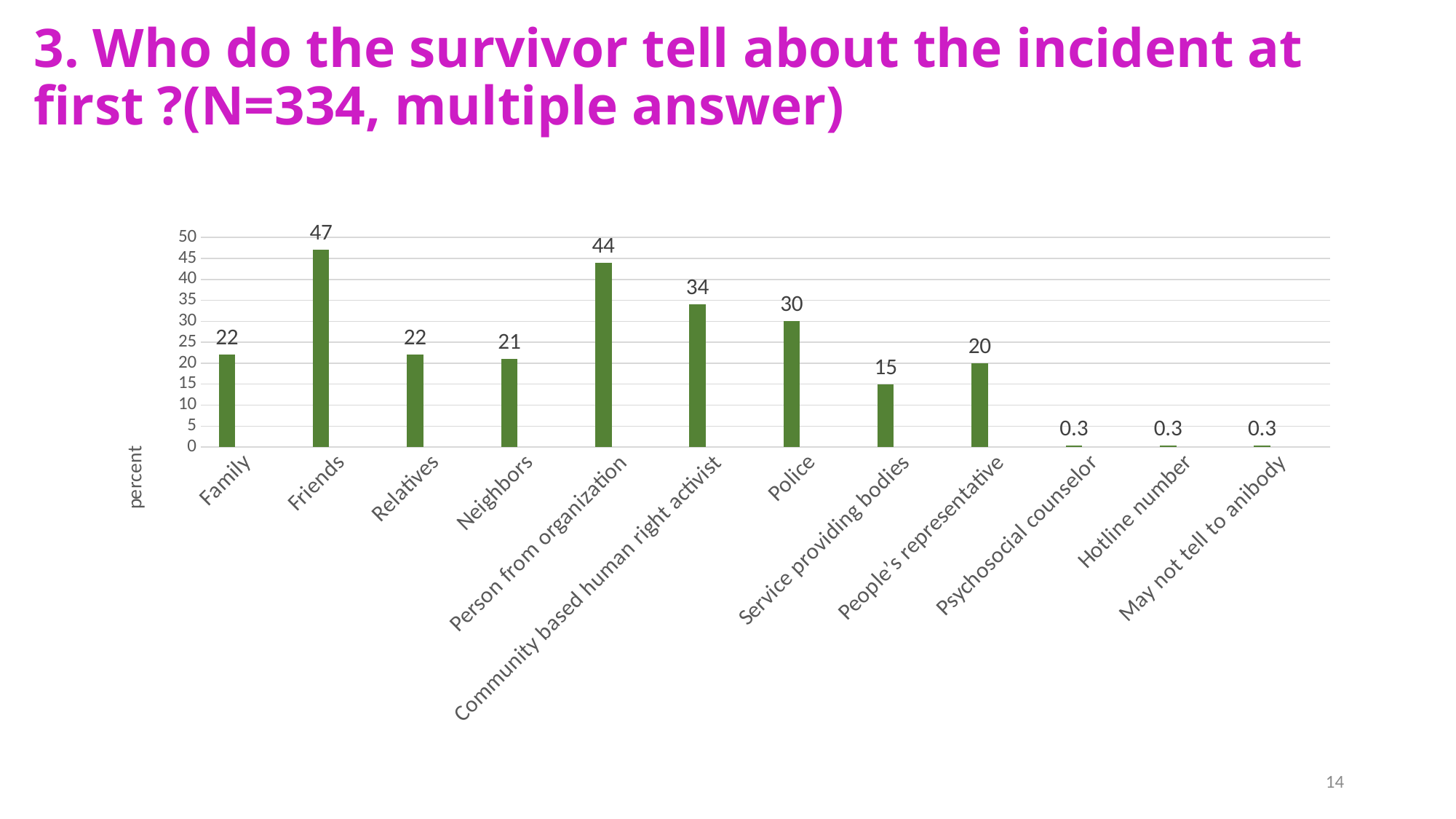
What kind of chart is shown on the slide? bar chart Which category has the highest value? Friends Which is larger, the value for Police or the value for Neighbors? Police How many categories are shown on the x axis? 12 Is the value for Community based human right activist greater or less than 30? greater What is the difference between the values for Friends and Police? 17 What is the value for Hotline number? 0.3 What is the label on the vertical axis? percent What is the value for Service providing bodies? 15 What is the value for Friends? 47 What is the difference between the values for Community based human right activist and People's representative? 14 What is the value for Person from organization? 44